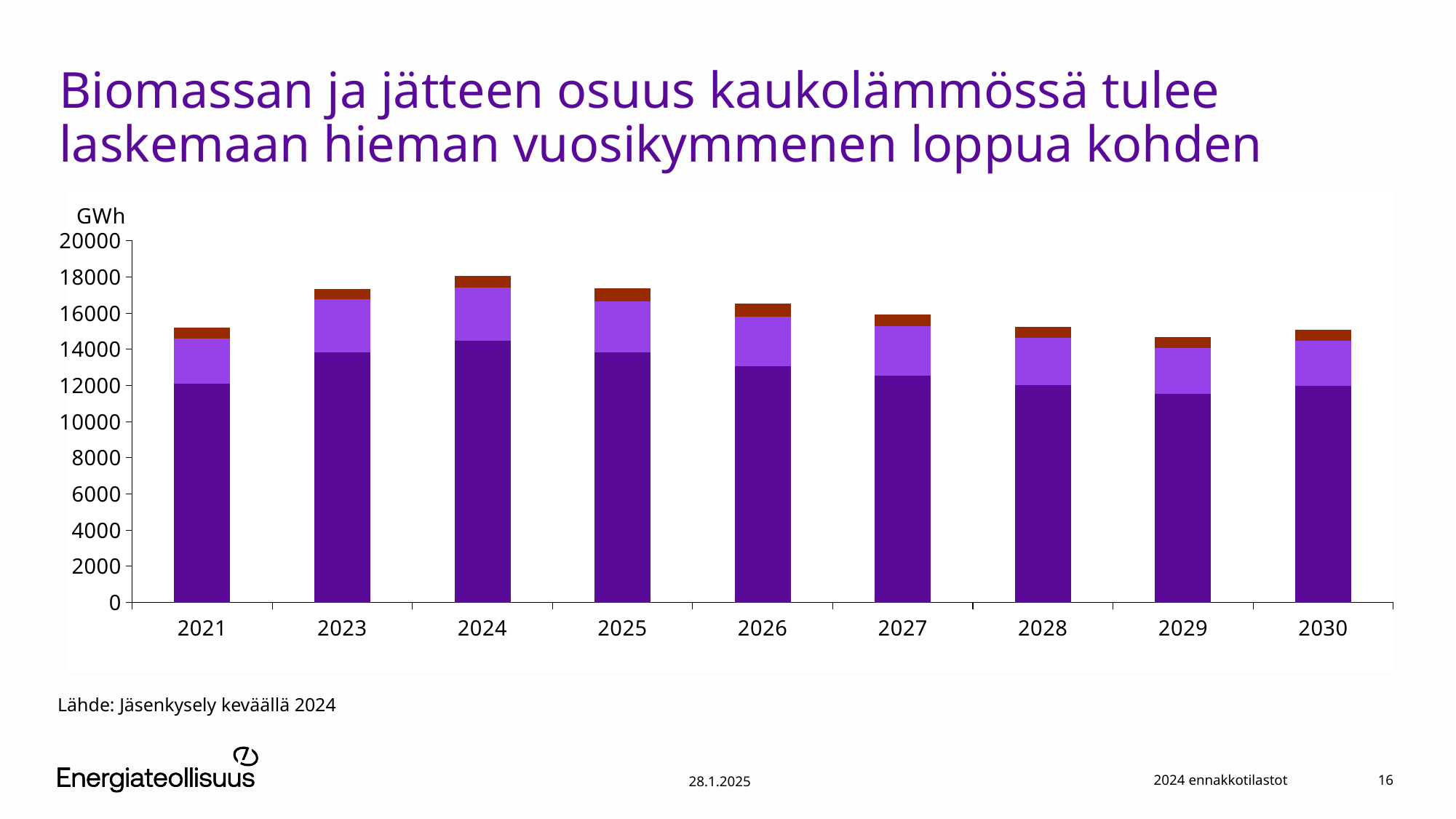
Is the total bar for 2026 greater or less than 14000 GWh? greater Which year has the larger total bar, 2023 or 2027? 2023 Is the total bar for 2029 greater or less than 16000 GWh? less Is the total bar for 2024 greater or less than 16000 GWh? greater What unit is shown on the y axis of the chart? GWh What kind of chart is shown on the slide? Stacked bar chart How many years are shown on the x axis of the chart? 9 How many coloured segments make up each stacked bar? 3 Do the total bars rise or fall from 2024 to 2029? fall Which year has the highest total bar in the chart? 2024